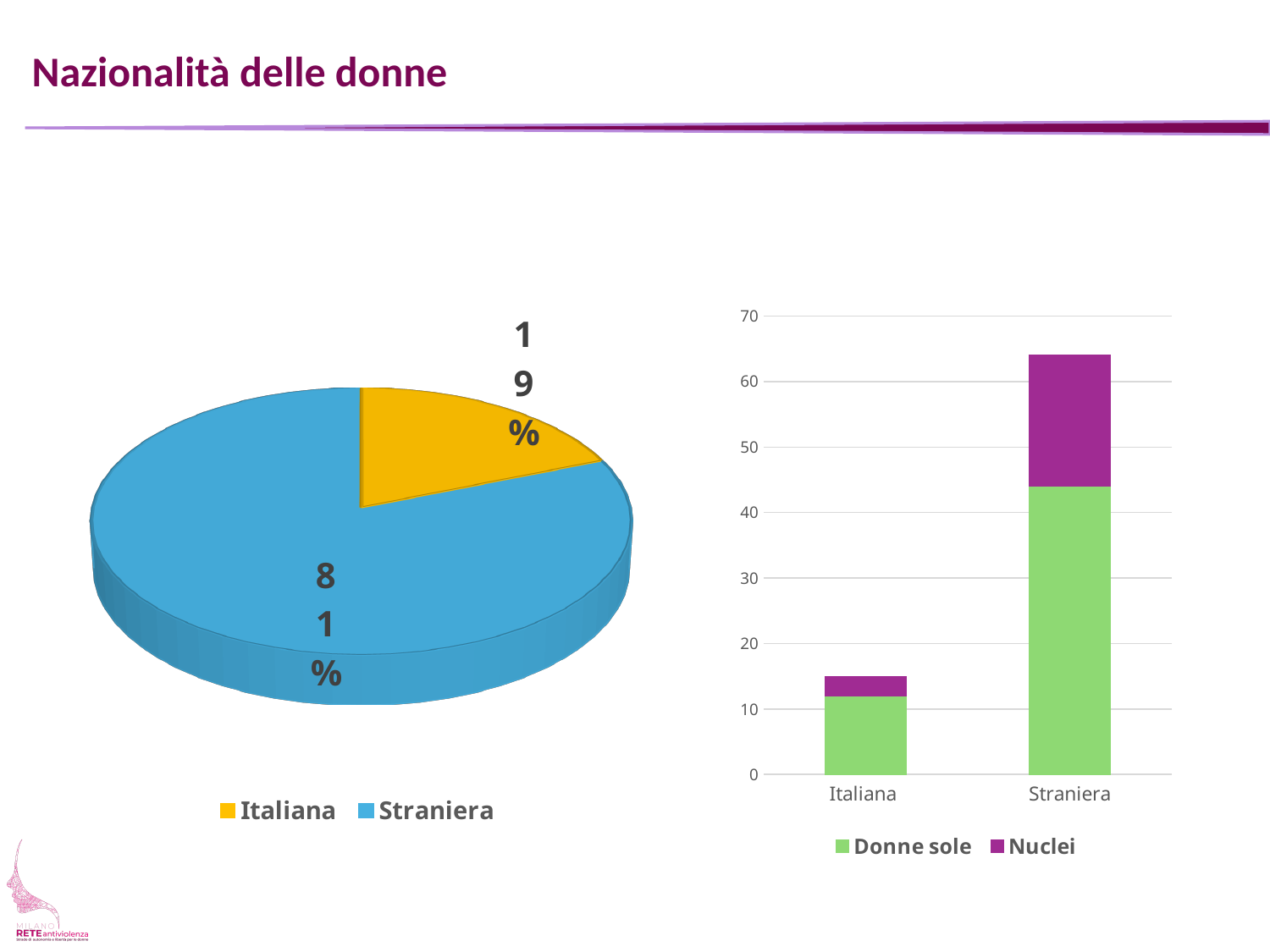
On the pie chart, which slice is the smallest? Italiana On the pie chart, how many slices are there? 2 On the pie chart, what share of the women is Italiana? 19% On the bar chart on the right, how many series does the legend list? 2 What kind of chart is the chart on the right of the slide? Bar chart On the bar chart on the right, is the total height of the Italiana bar greater or less than 20? less On the pie chart, what share of the women is Straniera? 81% On the bar chart on the right, which category has the taller stacked bar, Italiana or Straniera? Straniera On the bar chart on the right, is the total height of the Straniera bar greater or less than 60? greater On the pie chart, which slice is the largest? Straniera What kind of chart is the chart on the left of the slide? Pie chart On the pie chart, what is the difference in percentage points between the Straniera and Italiana slices? 62